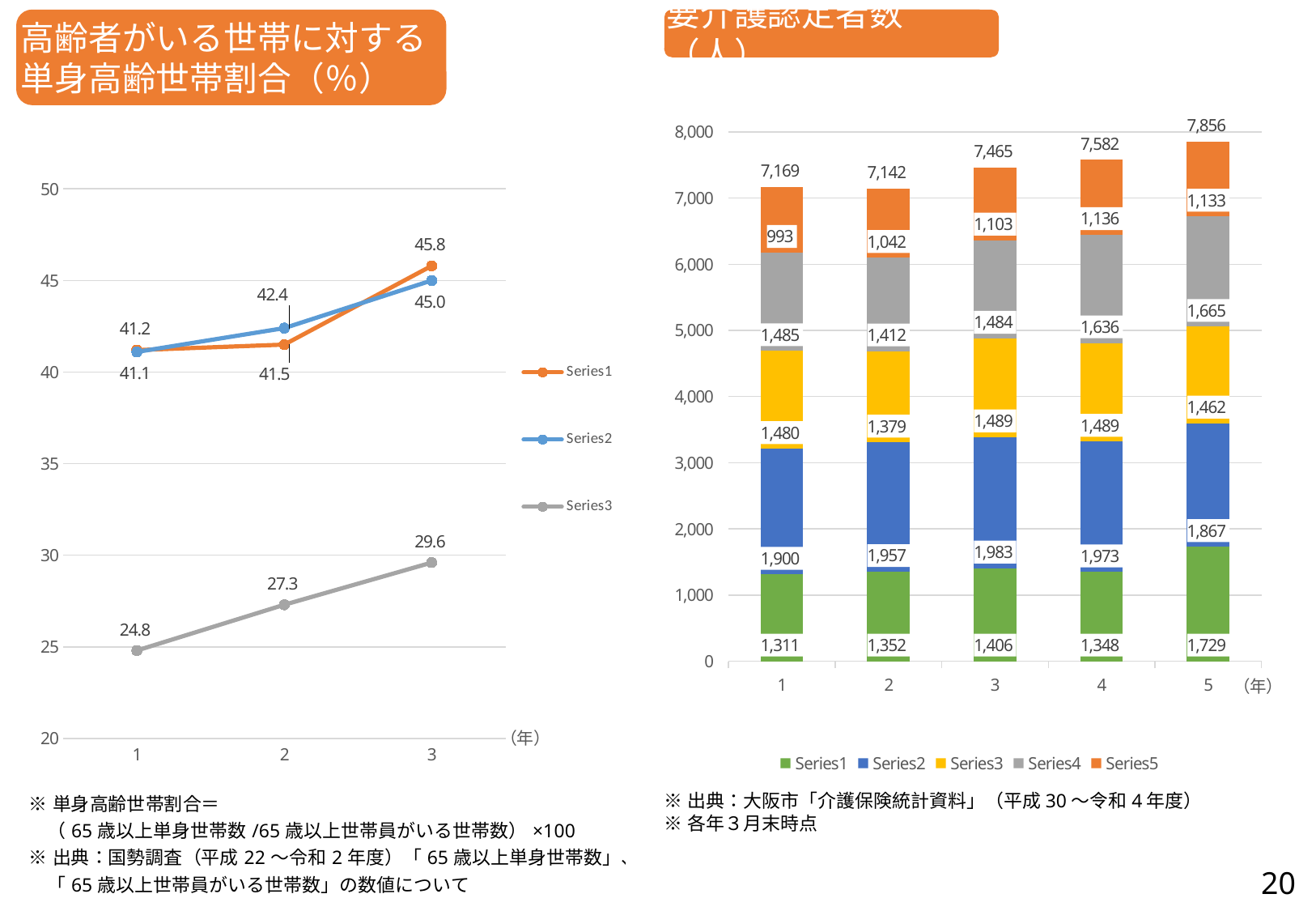
In the right chart, what is the value of Series5 for year 1? 993 In the left chart, what is the value of Series2 at year 2? 42.4 What kind of chart is the chart on the right (要介護認定者数)? stacked bar chart How many series does the legend of the right chart list? 5 In the right chart, what is the value of Series1 for year 5? 1,729 In the right chart, which year has the lowest stacked total? 2 In the left chart, what is the value of Series1 at year 3? 45.8 In the left chart, what is the value of Series3 at year 3? 29.6 In the left chart, does Series3 rise or fall from year 1 to year 3? rise In the left chart, by how much does Series3 increase from year 1 to year 3? 4.8 What kind of chart is the chart on the left (高齢者がいる世帯に対する単身高齢世帯割合)? line chart In the right chart, what is the total of the stacked bar for year 5? 7,856